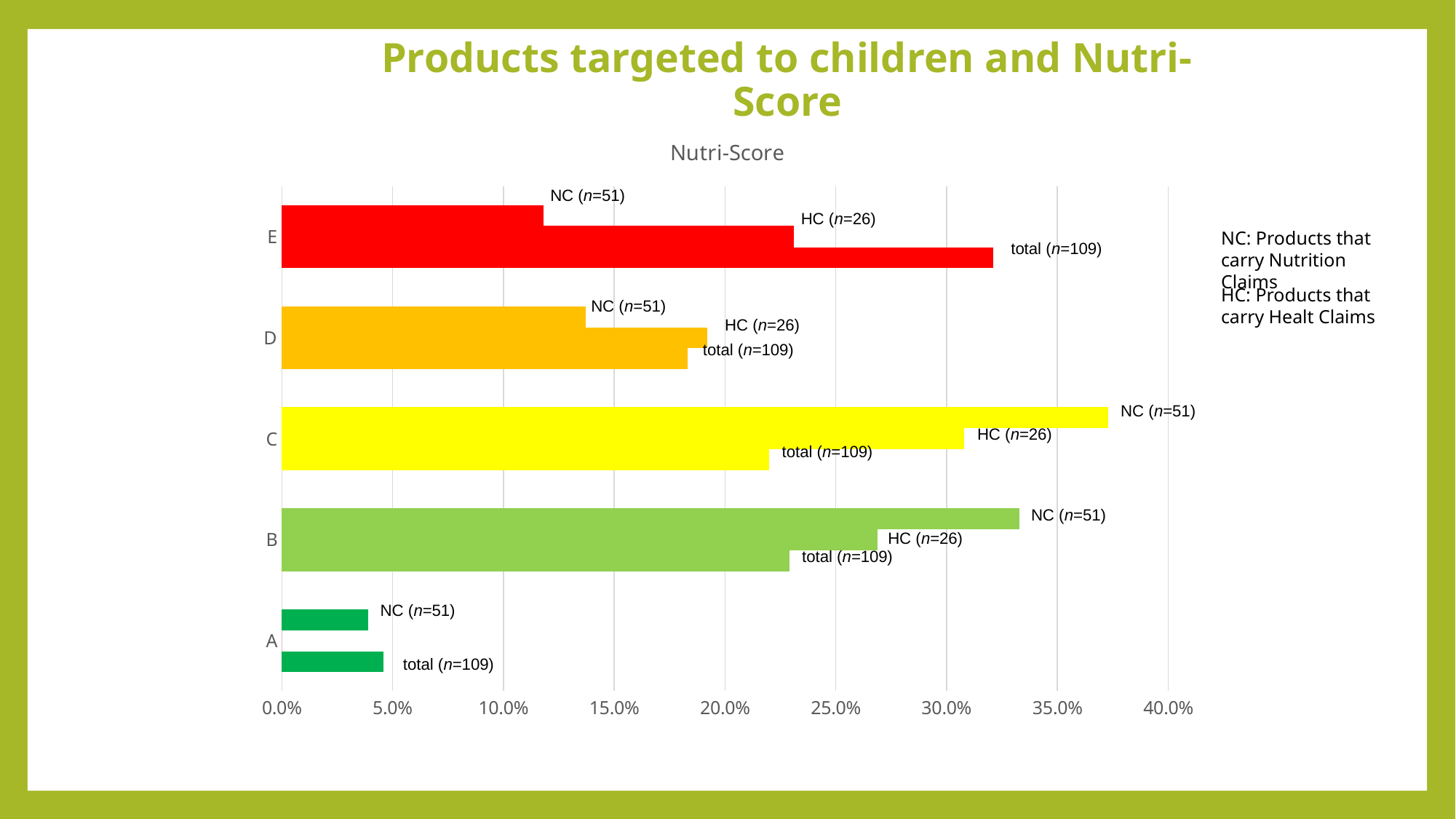
How many Nutri-Score categories are shown on the y axis? 5 How many bars are plotted for Nutri-Score category E? 3 Which Nutri-Score category has the lowest total (n=109) value? A Is the NC (n=51) value for category A greater or less than 5.0%? less Is the NC (n=51) value for category C greater or less than 35.0%? greater Which Nutri-Score category has the highest NC (n=51) value? C What is the title shown above the chart? Nutri-Score Which Nutri-Score category has the highest total (n=109) value? E How many bars are plotted for Nutri-Score category A? 2 What kind of chart is shown on the slide? bar chart For category C, which is larger: the NC (n=51) value or the HC (n=26) value? NC (n=51) Is the total (n=109) value for category E greater or less than 30.0%? greater